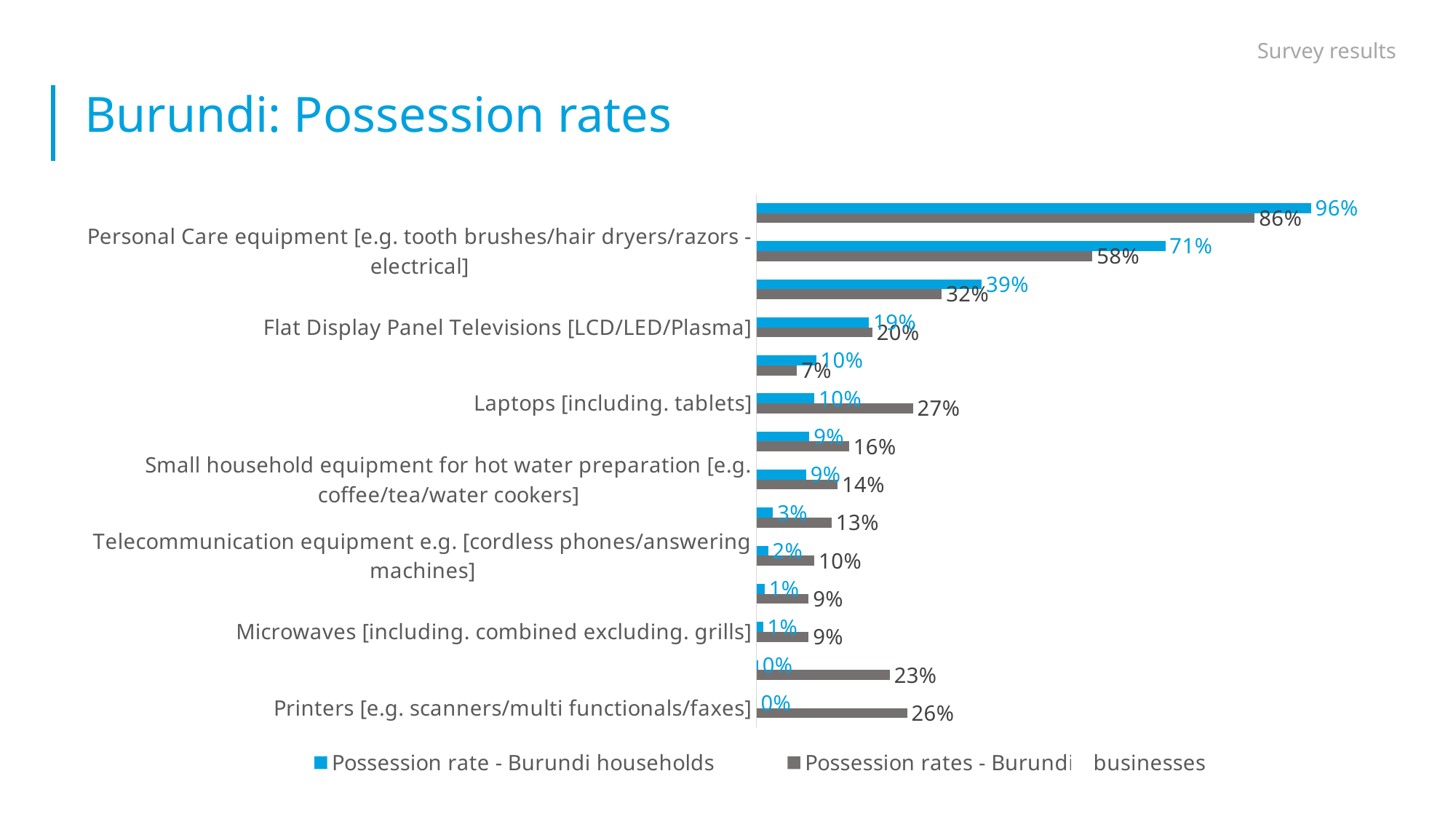
What is the possession rate for Burundi households for Telecommunication equipment e.g. [cordless phones/answering machines]? 2% What is the possession rate for Burundi businesses for Laptops [including. tablets]? 27% What kind of chart is shown on the slide? bar chart What is the possession rate for Burundi households for Flat Display Panel Televisions [LCD/LED/Plasma]? 19% What is the difference between the business and household possession rates for Laptops [including. tablets]? 17 percentage points For Laptops [including. tablets], which is larger: the household possession rate or the business possession rate? business possession rate How many series does the legend list? 2 What is the title of the slide? Burundi: Possession rates What is the possession rate for Burundi businesses for Microwaves [including. combined excluding. grills]? 9% What is the possession rate for Burundi businesses for Printers [e.g. scanners/multi functionals/faxes]? 26% What is the possession rate for Burundi households for Laptops [including. tablets]? 10% What is the highest possession rate shown for Burundi households? 96%